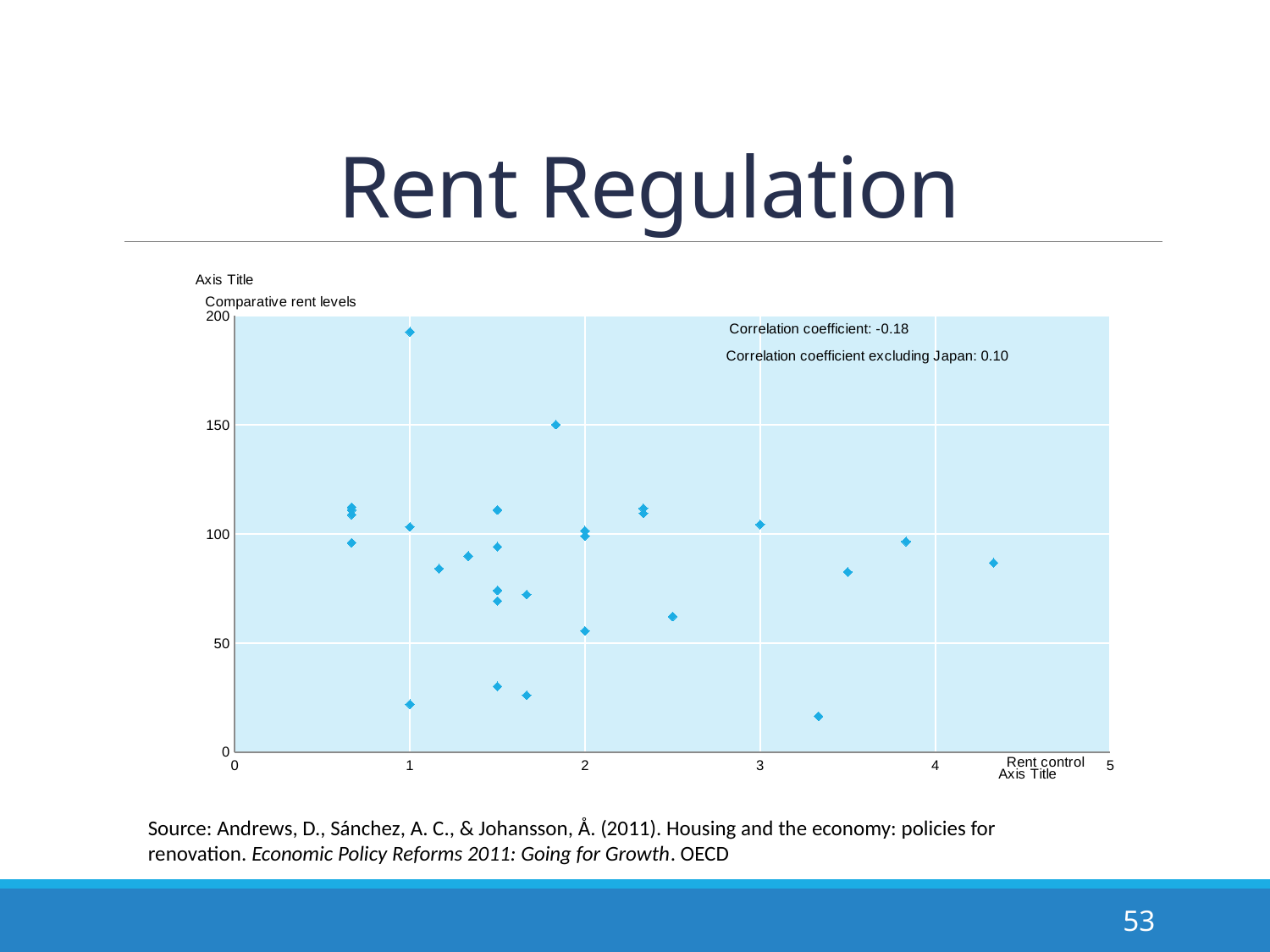
What correlation coefficient is stated on the chart when Japan is excluded? 0.10 Is the comparative rent level of the point plotted furthest right (rent control above 4) greater or less than 50? greater What correlation coefficient is stated on the chart for all points? -0.18 Is the comparative rent level of the point at rent control 3.5 greater or less than 100? less What kind of chart is shown on the slide? scatter chart Is the comparative rent level of the point near rent control 3.3 greater or less than 50? less